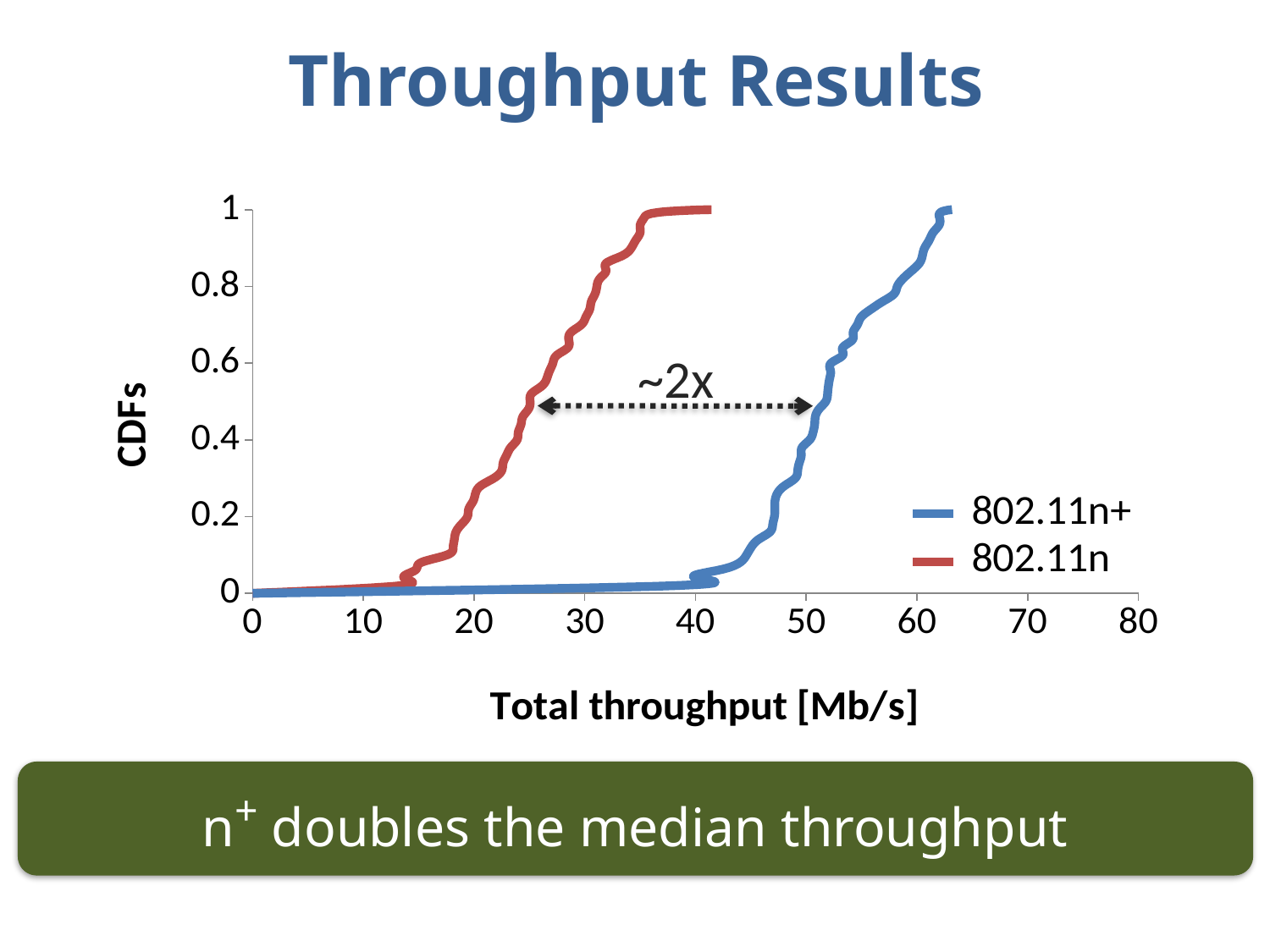
Which series has the lower median total throughput? 802.11n Is the total throughput at which the 802.11n CDF reaches 0.5 greater or less than 30 Mb/s? less Is the total throughput at which the 802.11n+ CDF reaches 0.5 greater or less than 40 Mb/s? greater What kind of chart is shown on the slide? line chart Do the CDF values rise or fall as total throughput increases along the x axis? rise What is the label of the x axis? Total throughput [Mb/s] Which series reaches higher total throughput values, 802.11n+ or 802.11n? 802.11n+ What is the title of the chart on the slide? Throughput Results What is the highest tick value shown on the x axis? 80 How many series does the legend list? 2 Is the maximum total throughput reached by the 802.11n+ curve greater or less than 60 Mb/s? greater